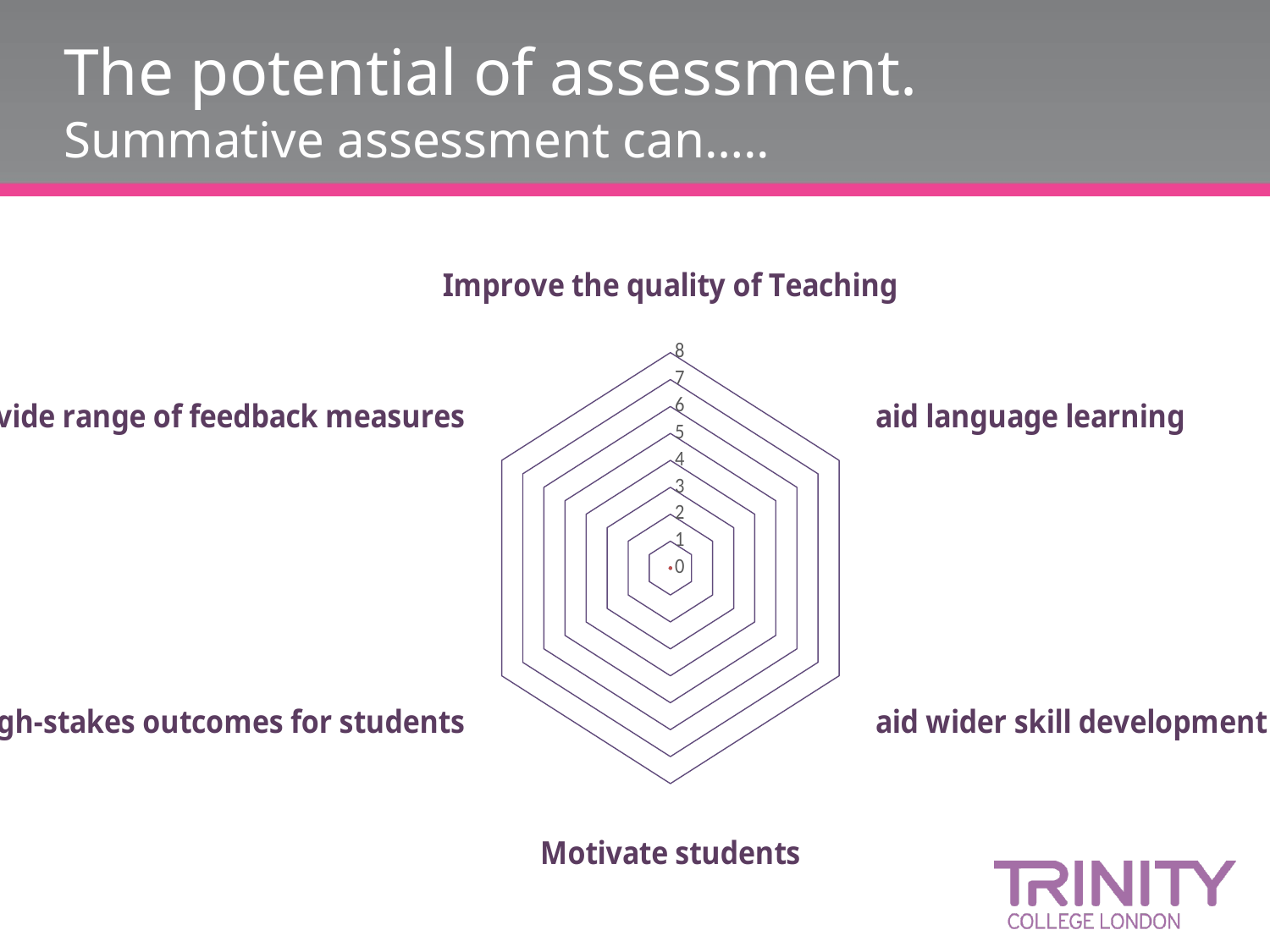
Which category label appears at the bottom of the radar chart? Motivate students Which category label appears at the top of the radar chart? Improve the quality of Teaching What is the highest value marked on the radar chart's scale? 8 What is the lowest value marked on the radar chart's scale? 0 What kind of chart is shown on the slide? radar chart How many category axes does the radar chart have? 6